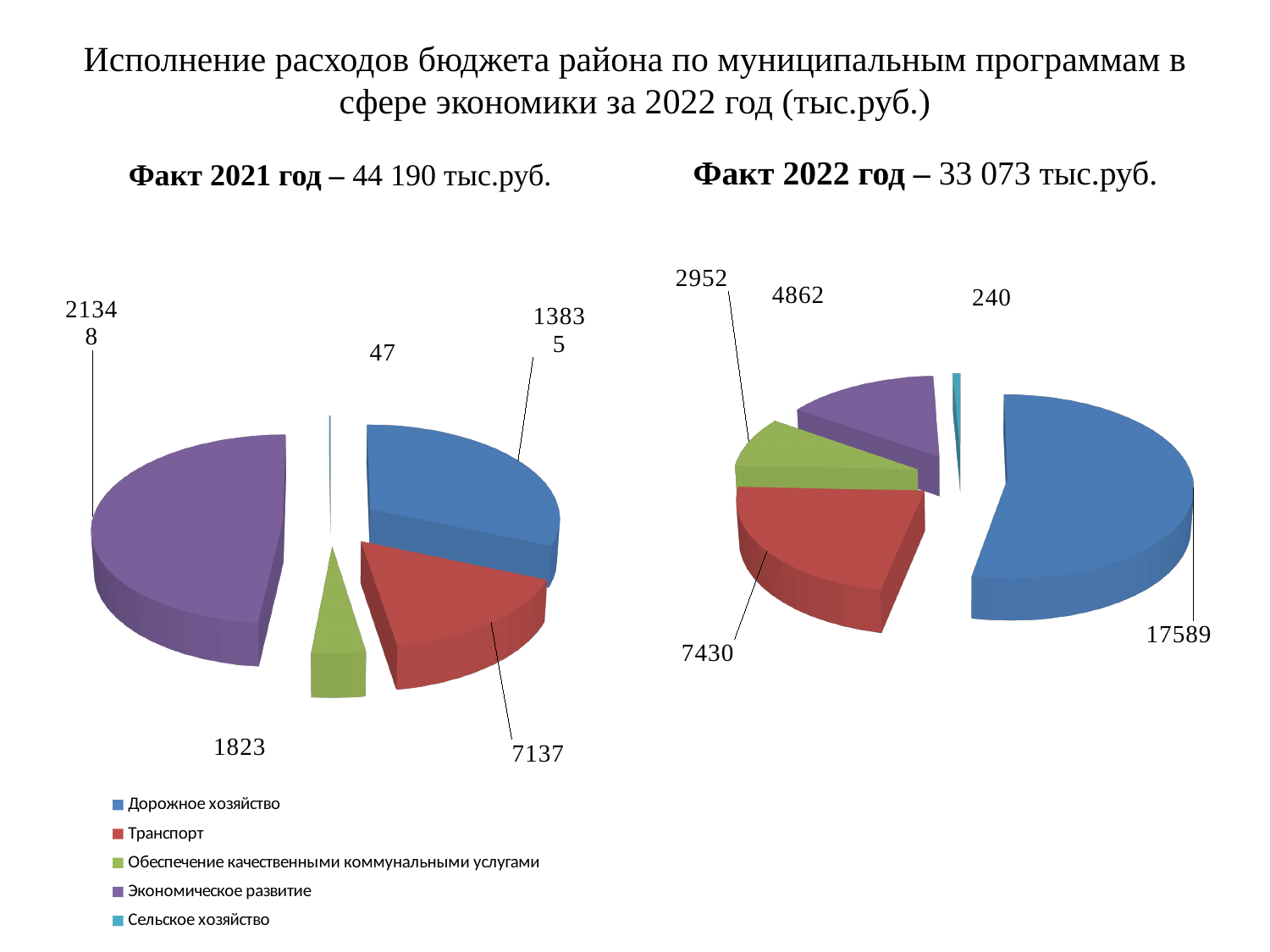
In the 2022 pie chart (Факт 2022 год), what share of the total 33 073 does Дорожное хозяйство (17589) represent, to one decimal place? 53.2% What type of chart is used on this slide for the 2021 and 2022 data? Pie chart In the 2021 pie chart (Факт 2021 год), which category has the smallest value? Сельское хозяйство In the 2021 pie chart (Факт 2021 год), what is the value for Дорожное хозяйство? 13835 In the 2022 pie chart (Факт 2022 год), which category has the largest value? Дорожное хозяйство In the 2021 pie chart (Факт 2021 год), which is larger: Экономическое развитие or Дорожное хозяйство? Экономическое развитие Which colour represents Транспорт in the pie charts? Red In the 2022 pie chart (Факт 2022 год), what is the value for Сельское хозяйство? 240 How many categories does the legend list for the pie charts? 5 In the 2022 pie chart (Факт 2022 год), what is the difference between Дорожное хозяйство and Транспорт? 10159 In the 2022 pie chart (Факт 2022 год), what is the value for Транспорт? 7430 In the 2021 pie chart (Факт 2021 год), what is the value for Экономическое развитие? 21348